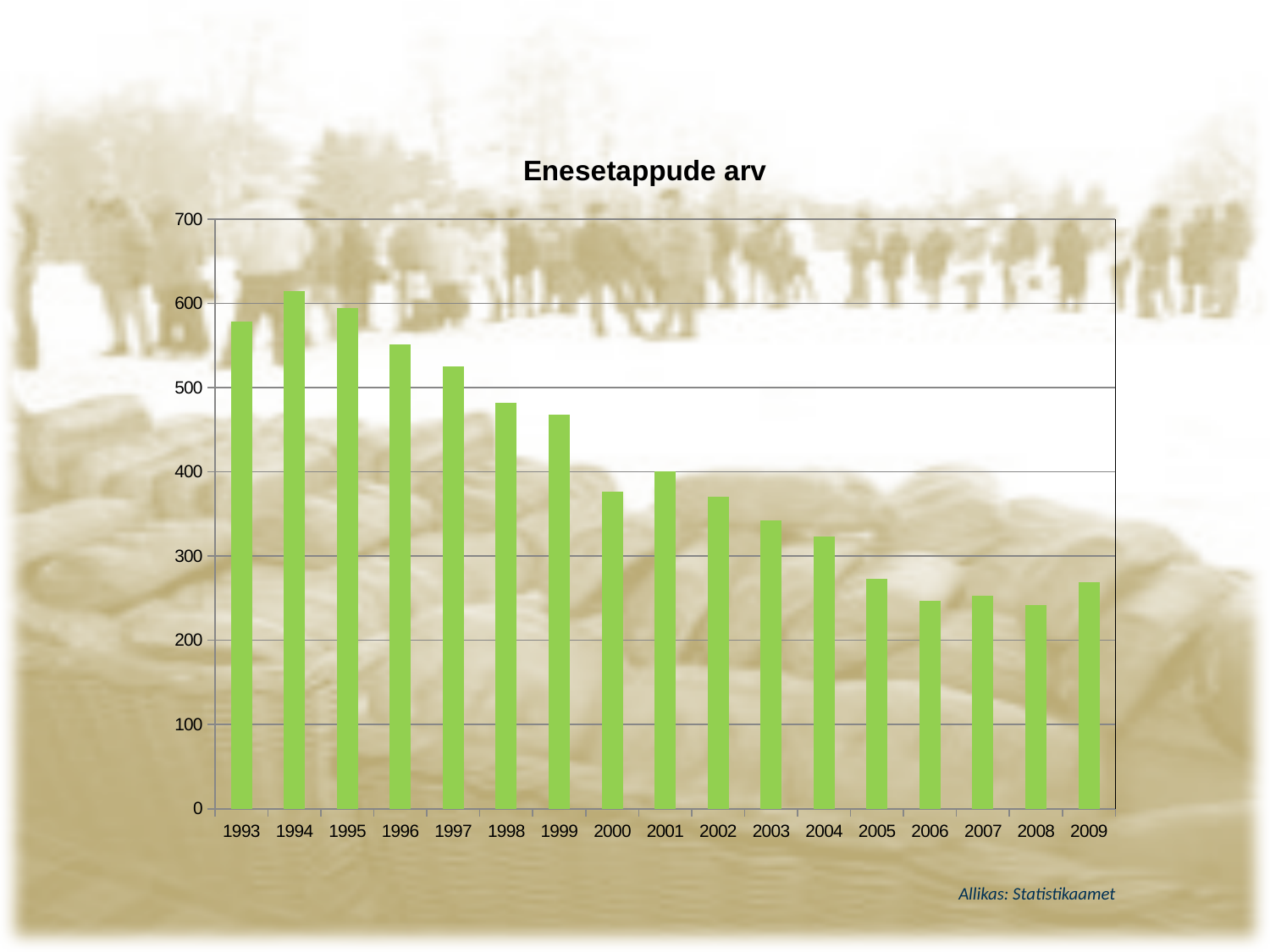
Is the value for 1993 greater or less than 500? greater Which year has the larger value, 1993 or 2009? 1993 Is the value for 2005 greater or less than 300? less Is the value for 1998 greater or less than 500? less Which year has the highest bar in the chart? 1994 What is the title of the chart? Enesetappude arv Do the values generally rise or fall from 1993 to 2009? fall What source is cited below the chart? Statistikaamet What type of chart is shown on the slide? bar chart How many years (bars) are shown on the x axis of the chart? 17